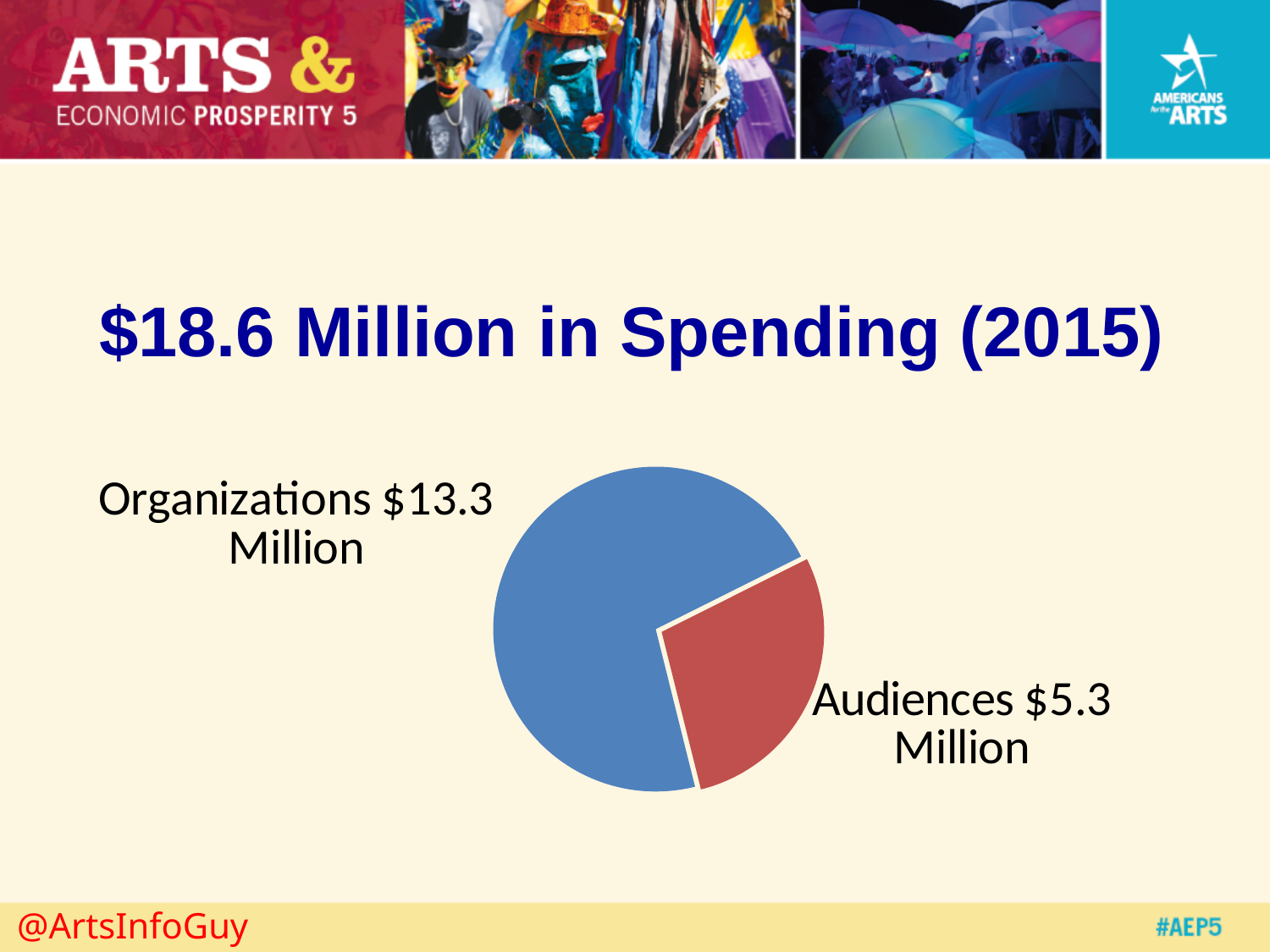
Which slice of the pie chart is the largest? Organizations Which slice of the pie chart is the smallest? Audiences What colour is the Audiences slice of the pie chart? red How much spending is attributed to Audiences in the pie chart? $5.3 Million Which is larger, spending by Organizations or spending by Audiences? Organizations What kind of chart is shown on the slide? pie chart To the nearest whole percent, what share of total spending does the Audiences slice represent? 28% How many slices does the pie chart have? 2 What is the total spending shown across both slices of the pie chart? $18.6 Million What is the title of the slide above the pie chart? $18.6 Million in Spending (2015) What is the difference between Organizations spending and Audiences spending? $8.0 Million How much spending is attributed to Organizations in the pie chart? $13.3 Million